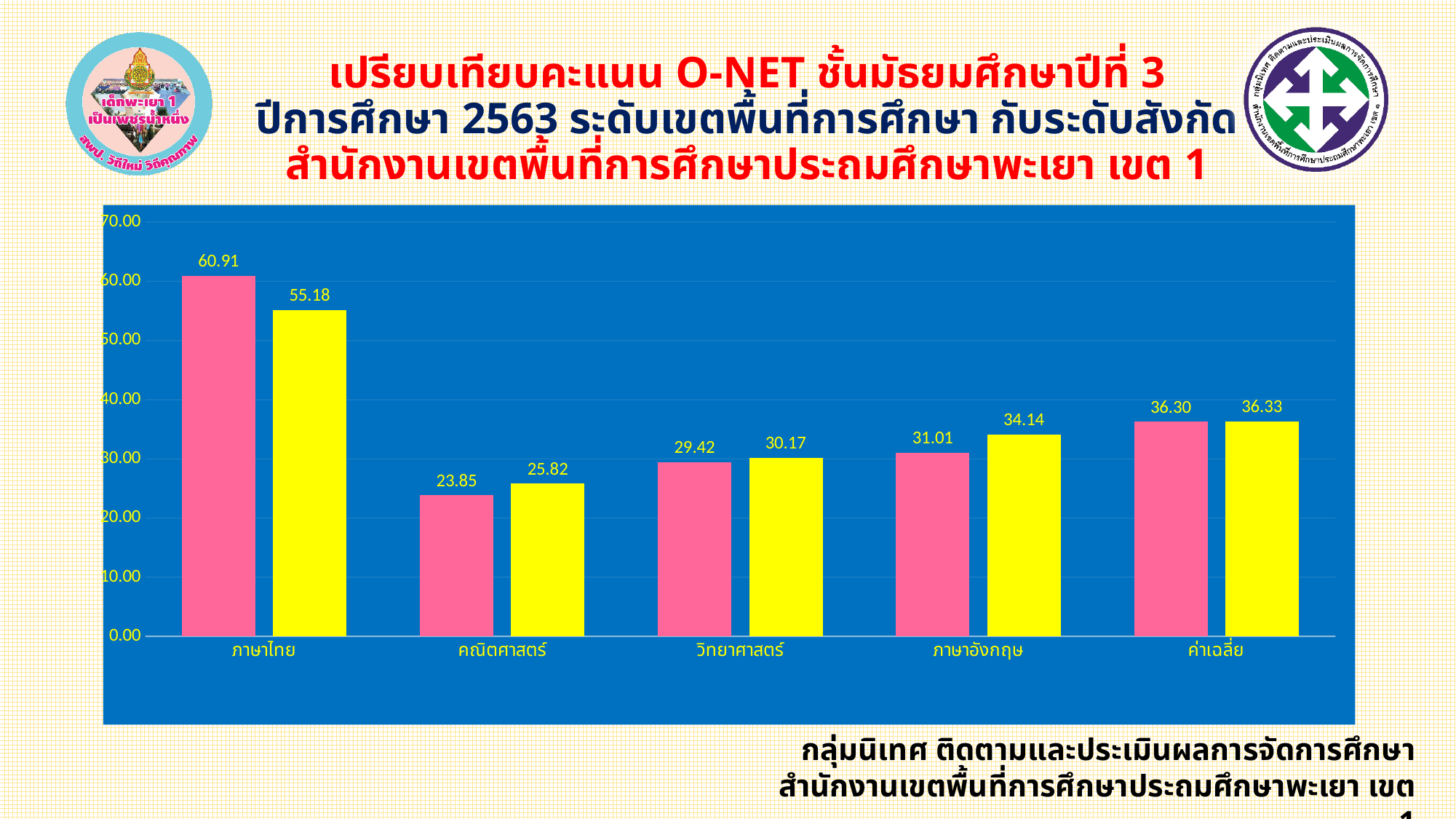
Which category has the lowest yellow bar? คณิตศาสตร์ How many categories are shown on the x axis? 5 What is the difference between the pink and yellow bars for ภาษาไทย? 5.73 What is the value of the yellow bar for ภาษาไทย? 55.18 For วิทยาศาสตร์, which bar is larger, the pink or the yellow one? yellow What is the value of the yellow bar for ค่าเฉลี่ย? 36.33 What is the value of the yellow bar for ภาษาอังกฤษ? 34.14 Which category has the highest pink bar? ภาษาไทย What is the value of the pink bar for คณิตศาสตร์? 23.85 What kind of chart is shown on the slide? bar chart What colours are the two series of bars in the chart? pink and yellow What is the value of the pink bar for ภาษาไทย? 60.91